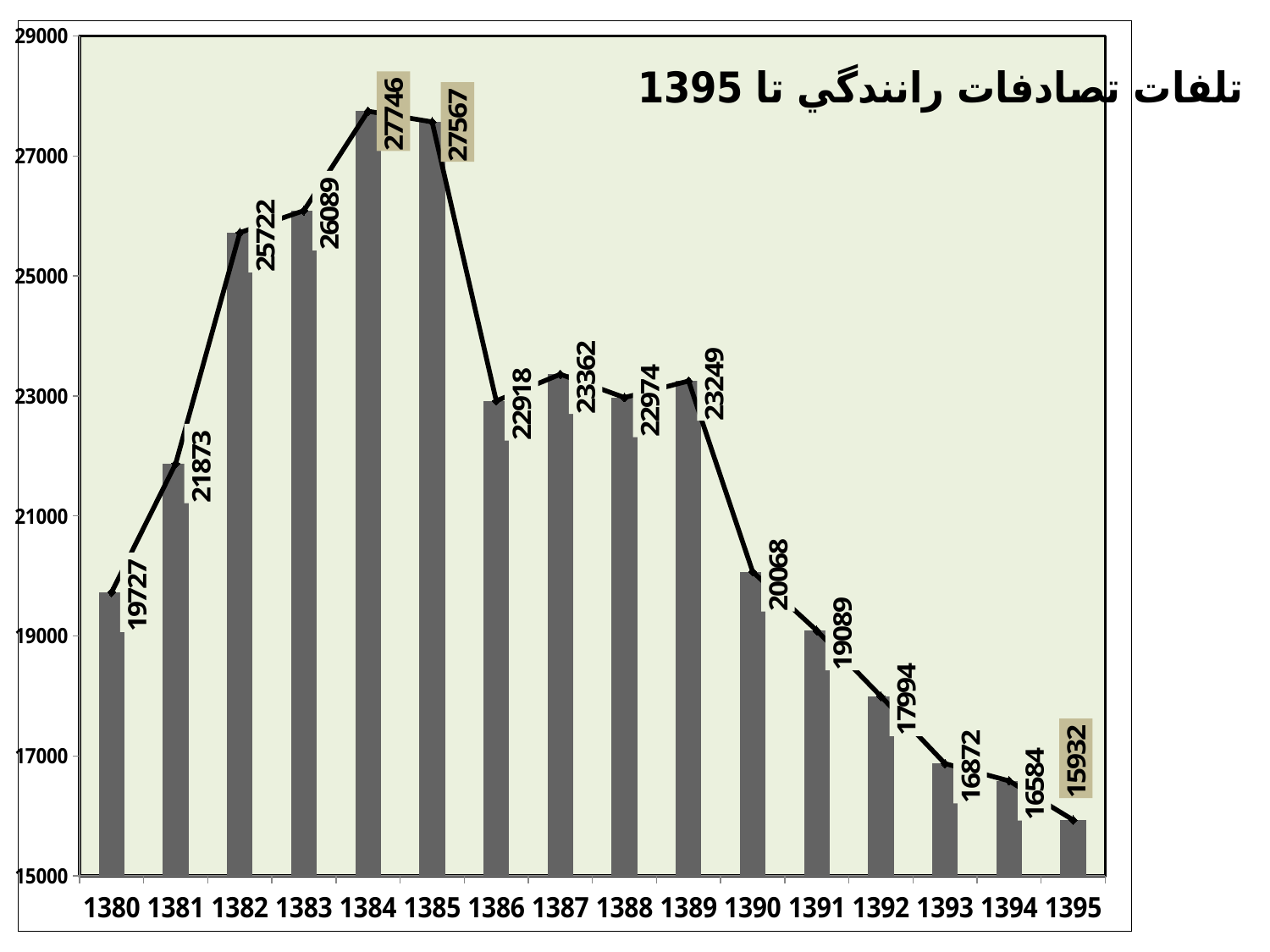
What is the value for 1395? 15932 How many years are shown on the x axis? 16 What is the difference between the values for 1384 and 1385? 179 Do the values rise or fall from 1389 to 1395? Fall What is the value for 1380? 19727 Which is larger, the value for 1387 or the value for 1389? 1387 Which year has the highest value? 1384 What is the difference between the values for 1380 and 1395? 3795 What is the value for 1384? 27746 Which year has the lowest value? 1395 What kind of chart is this? Bar chart with a line overlay What is the value for 1390? 20068